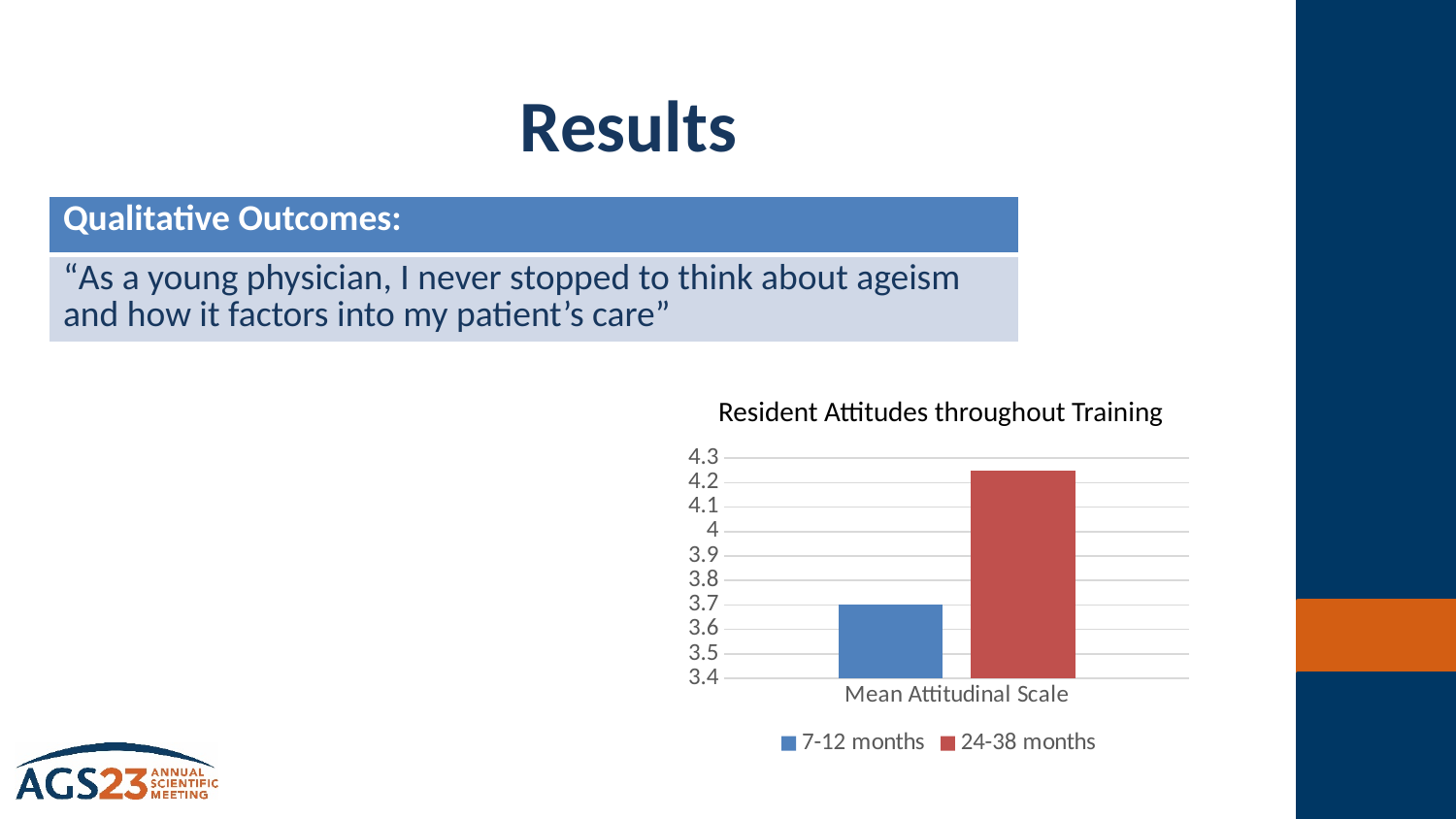
Is the value for 24-38 months greater or less than 4? greater Is the value for 7-12 months greater or less than 3.8? less Which series has the larger value: 7-12 months or 24-38 months? 24-38 months Which series has the highest bar in the chart? 24-38 months What kind of chart is shown on the slide? bar chart Which series has the lowest bar in the chart? 7-12 months How many categories are plotted on the x axis of the chart? 1 Is the value for 24-38 months greater or less than 4.2? greater What is the category label shown on the x axis of the chart? Mean Attitudinal Scale What is the title of the chart? Resident Attitudes throughout Training What is the value of the 7-12 months bar for Mean Attitudinal Scale? 3.7 How many series does the legend of the chart list? 2